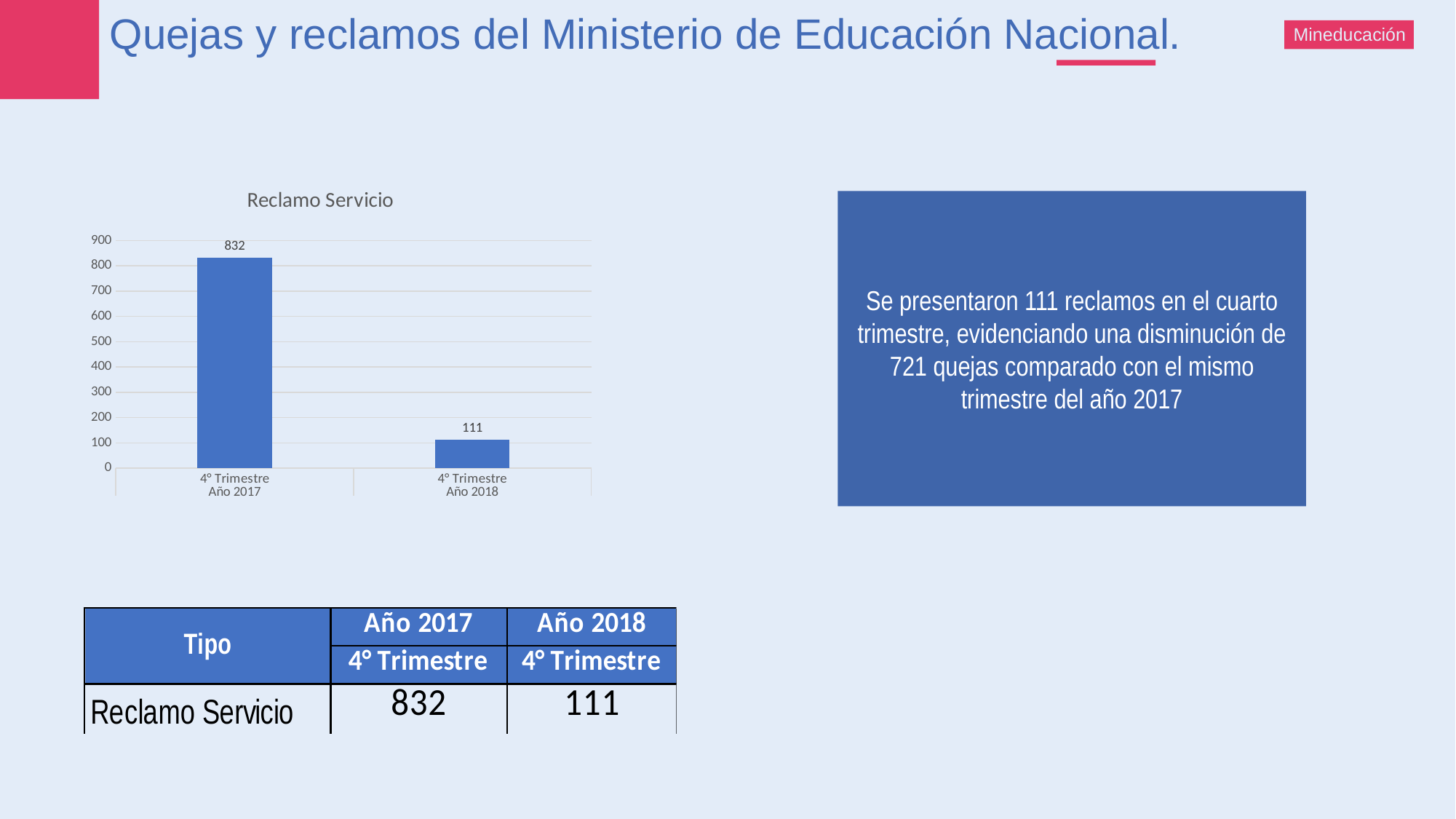
How many categories are shown in the Reclamo Servicio chart? 2 What is the difference between the 4° Trimestre Año 2017 and 4° Trimestre Año 2018 values in the Reclamo Servicio chart? 721 Which is larger in the Reclamo Servicio chart: 4° Trimestre Año 2017 or 4° Trimestre Año 2018? 4° Trimestre Año 2017 What is the value for 4° Trimestre Año 2018 in the Reclamo Servicio chart? 111 Is the value for 4° Trimestre Año 2017 greater or less than 800? greater Do the values rise or fall from 4° Trimestre Año 2017 to 4° Trimestre Año 2018 in the Reclamo Servicio chart? fall Which category has the lowest value in the Reclamo Servicio chart? 4° Trimestre Año 2018 What is the value for 4° Trimestre Año 2017 in the Reclamo Servicio chart? 832 What is the title of the chart on the slide? Reclamo Servicio Is the value for 4° Trimestre Año 2018 greater or less than 200? less Which category has the highest value in the Reclamo Servicio chart? 4° Trimestre Año 2017 What kind of chart is the Reclamo Servicio chart? bar chart